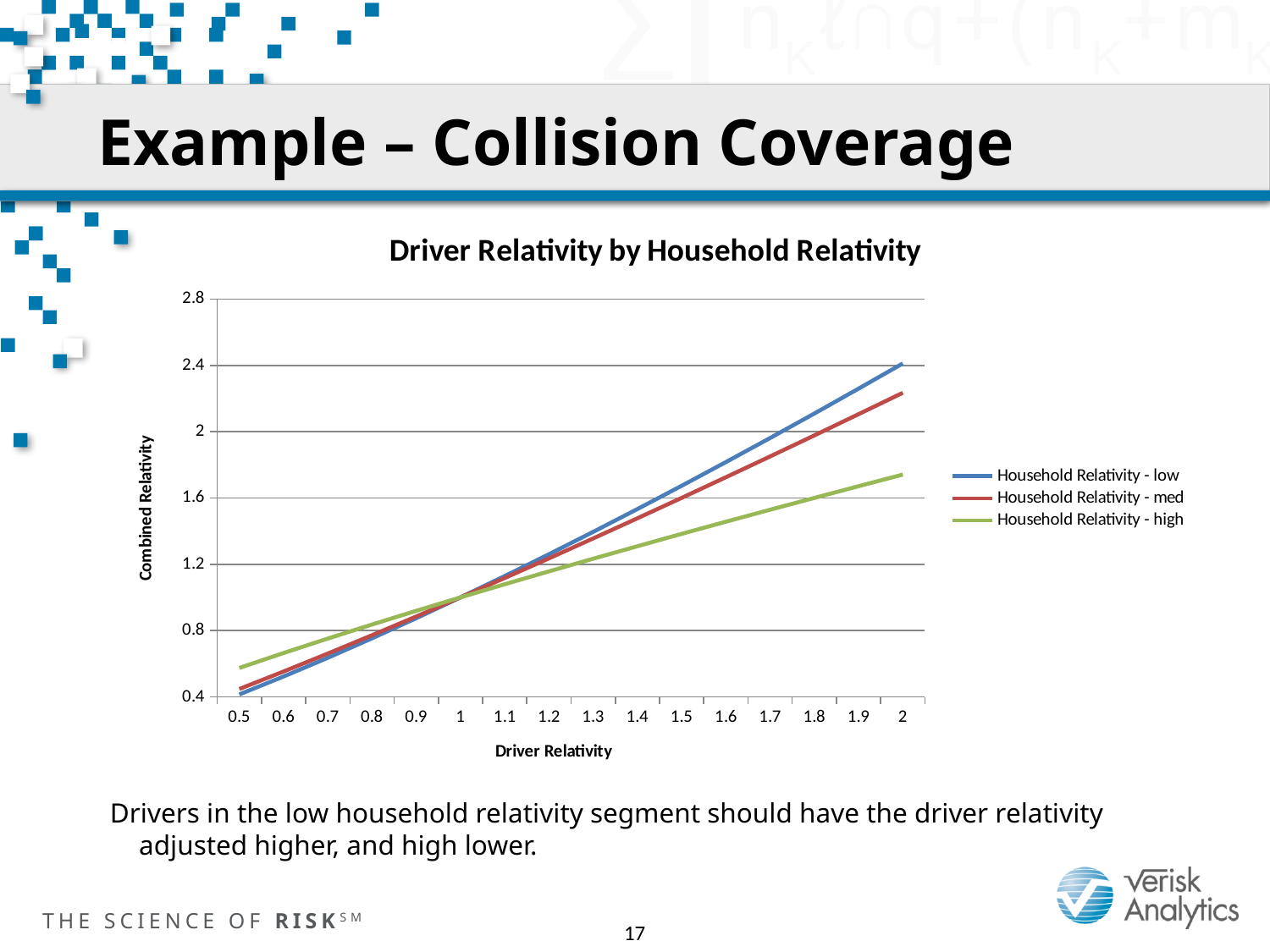
Is the value for Household Relativity - med at driver relativity 2 greater or less than 2? greater Which series reaches the highest combined relativity at driver relativity 2? Household Relativity - low What kind of chart is shown on the slide? line chart At driver relativity 0.5, which series has the higher combined relativity: Household Relativity - high or Household Relativity - low? Household Relativity - high How many driver relativity values are marked along the x axis? 16 How many series does the legend list? 3 Is the value for Household Relativity - low at driver relativity 2 greater or less than 2? greater Do the combined relativity values rise or fall as driver relativity increases? rise Is the value for Household Relativity - high at driver relativity 2 greater or less than 2? less At driver relativity 2, which series has the higher combined relativity: Household Relativity - low or Household Relativity - high? Household Relativity - low What is the title of the chart? Driver Relativity by Household Relativity